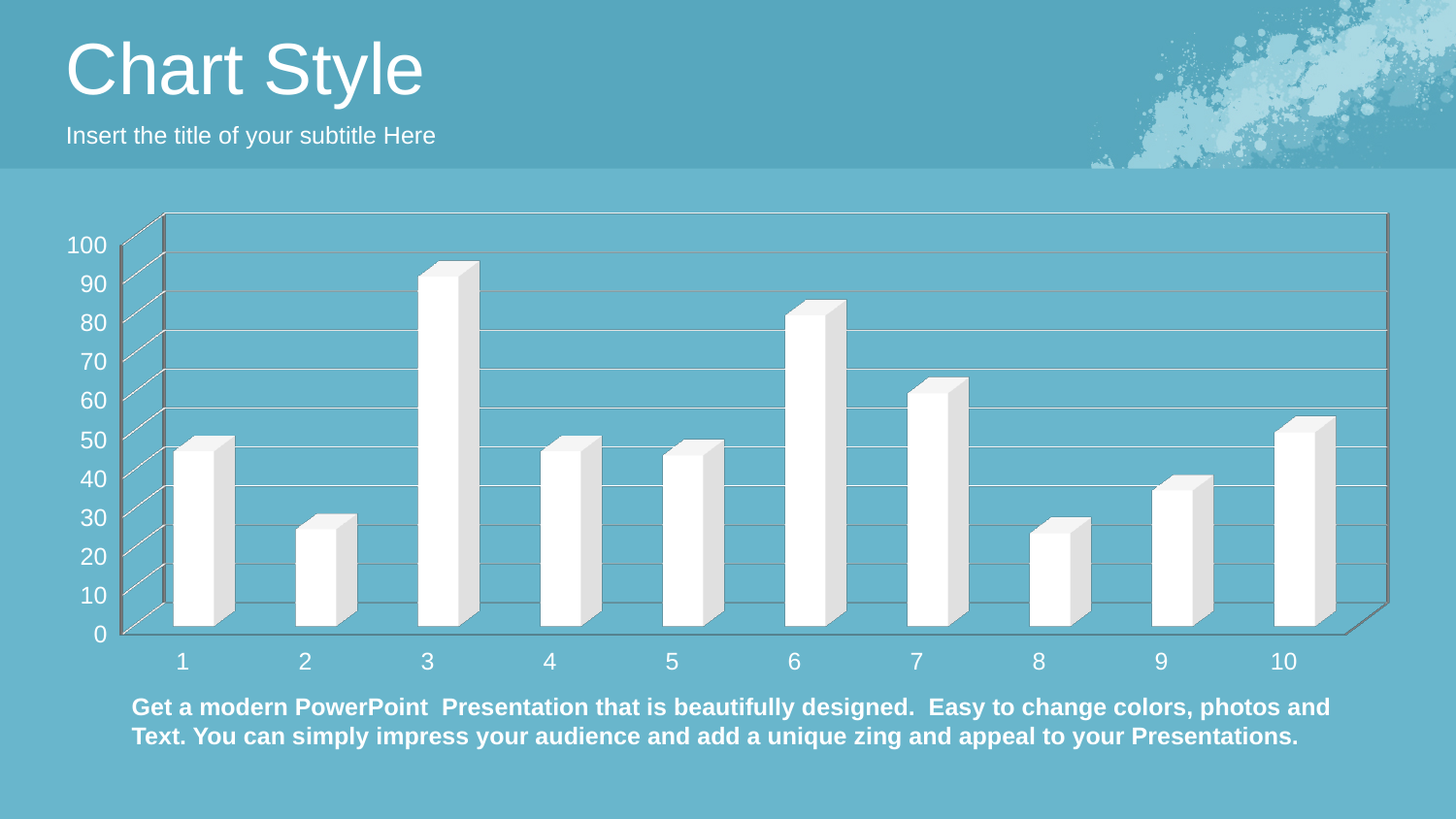
Which has the larger value, category 7 or category 9? 7 Is the value for category 9 greater or less than 40? less How many categories are plotted on the x axis of the chart? 10 Is the value for category 2 greater or less than 30? less Which category has the highest bar in the chart? 3 Which has the larger value, category 6 or category 10? 6 Is the value for category 8 greater or less than 30? less What kind of chart is shown on the slide? bar chart Which has the larger value, category 3 or category 6? 3